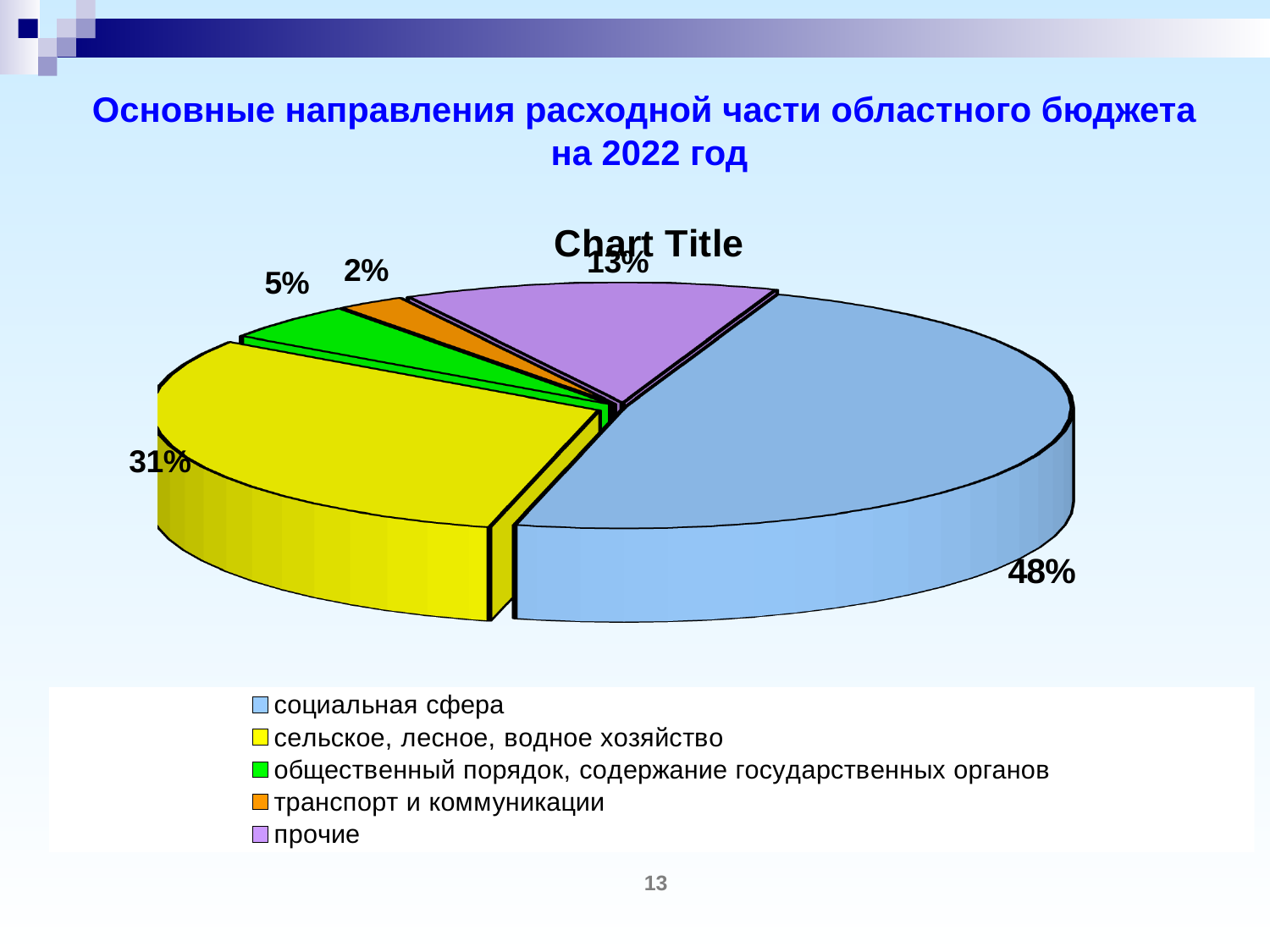
Which category has the largest slice of the pie? социальная сфера Which is larger: the share for "прочие" or the share for "общественный порядок, содержание государственных органов"? прочие How many categories does the legend list? 5 What share of the pie does "прочие" have? 13% What share of the pie does "социальная сфера" have? 48% What share of the pie does "общественный порядок, содержание государственных органов" have? 5% What is the difference in percentage points between "социальная сфера" and "сельское, лесное, водное хозяйство"? 17 What kind of chart is shown on the slide? pie chart Which category has the smallest slice of the pie? транспорт и коммуникации What colour is the slice for "сельское, лесное, водное хозяйство"? yellow